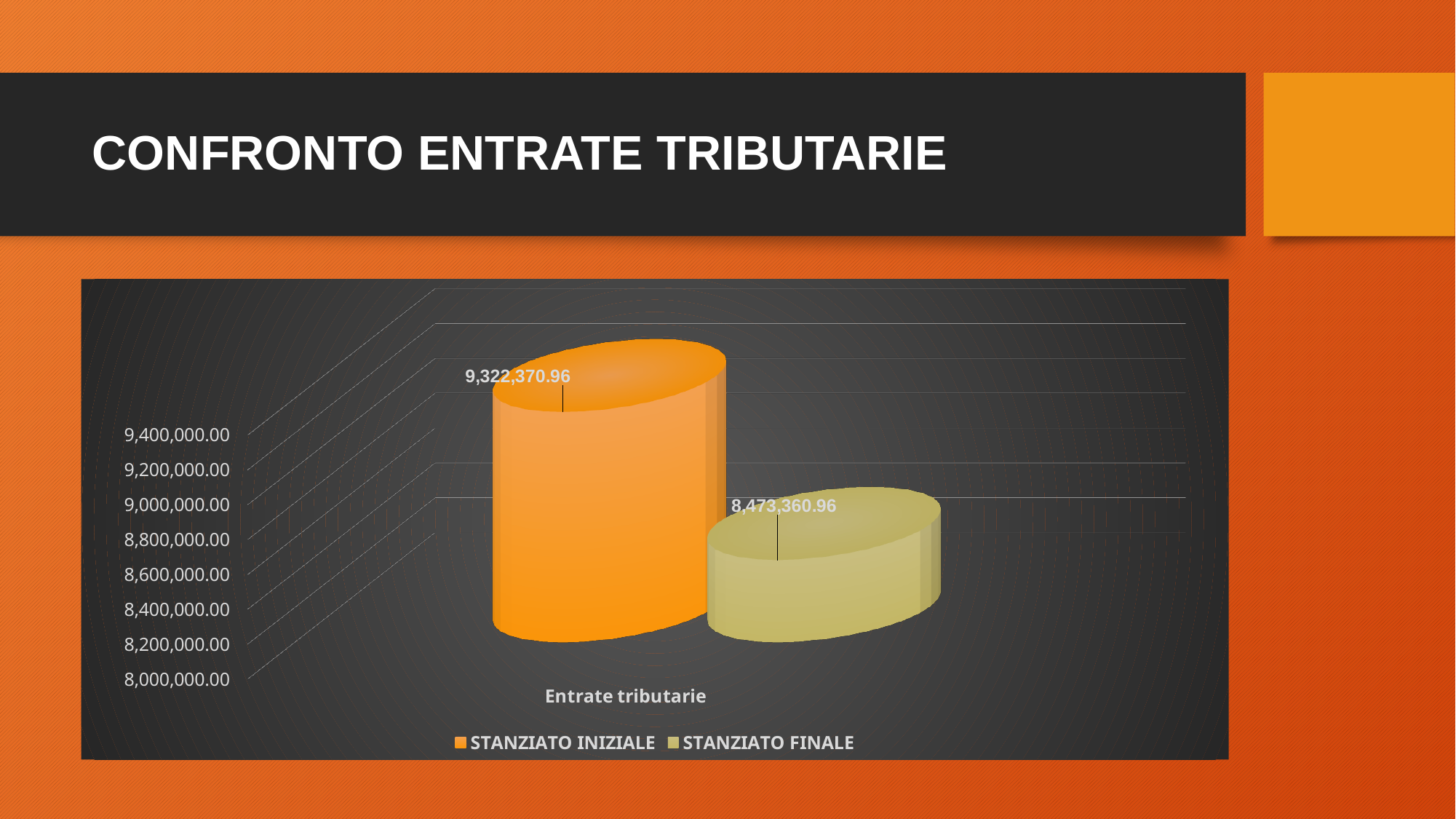
What is the value of STANZIATO INIZIALE for Entrate tributarie? 9,322,370.96 What is the title of the slide? CONFRONTO ENTRATE TRIBUTARIE What is the value of STANZIATO FINALE for Entrate tributarie? 8,473,360.96 Which series has the lower value for Entrate tributarie? STANZIATO FINALE Is the value for STANZIATO FINALE greater or less than 9,000,000.00? less What kind of chart is shown on the slide? bar chart Which series has the higher value for Entrate tributarie? STANZIATO INIZIALE What is the difference between STANZIATO INIZIALE and STANZIATO FINALE? 849,010.00 How many series does the legend list? 2 Is STANZIATO INIZIALE larger or smaller than STANZIATO FINALE? larger Is the value for STANZIATO INIZIALE greater or less than 9,200,000.00? greater How many categories are shown on the x axis? 1